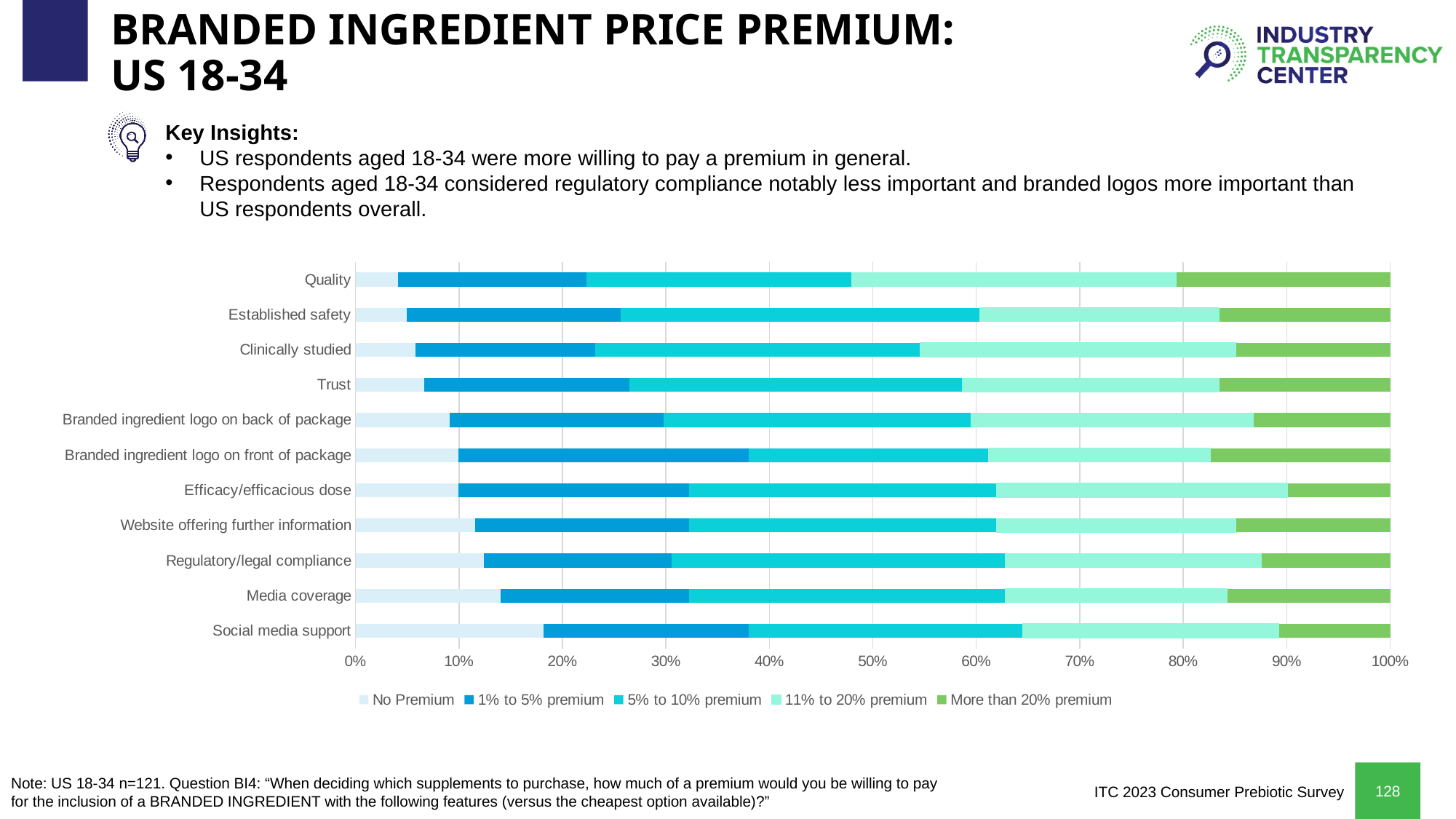
Which category has the smallest 'No Premium' share? Quality What is the first category listed at the top of the chart? Quality Which legend entry is shown in the darkest green colour? More than 20% premium What kind of chart is shown on the slide? Stacked bar chart Which has the larger 'No Premium' share: Media coverage or Established safety? Media coverage Is the 'No Premium' value for Media coverage greater or less than 10%? greater How many series does the chart legend list? 5 Is the 'No Premium' value for Social media support greater or less than 10%? greater Which category has the largest 'No Premium' share? Social media support How many categories (features) are plotted on the chart? 11 Is the 'No Premium' value for Quality greater or less than 10%? less Which has the larger 'No Premium' share: Quality or Regulatory/legal compliance? Regulatory/legal compliance